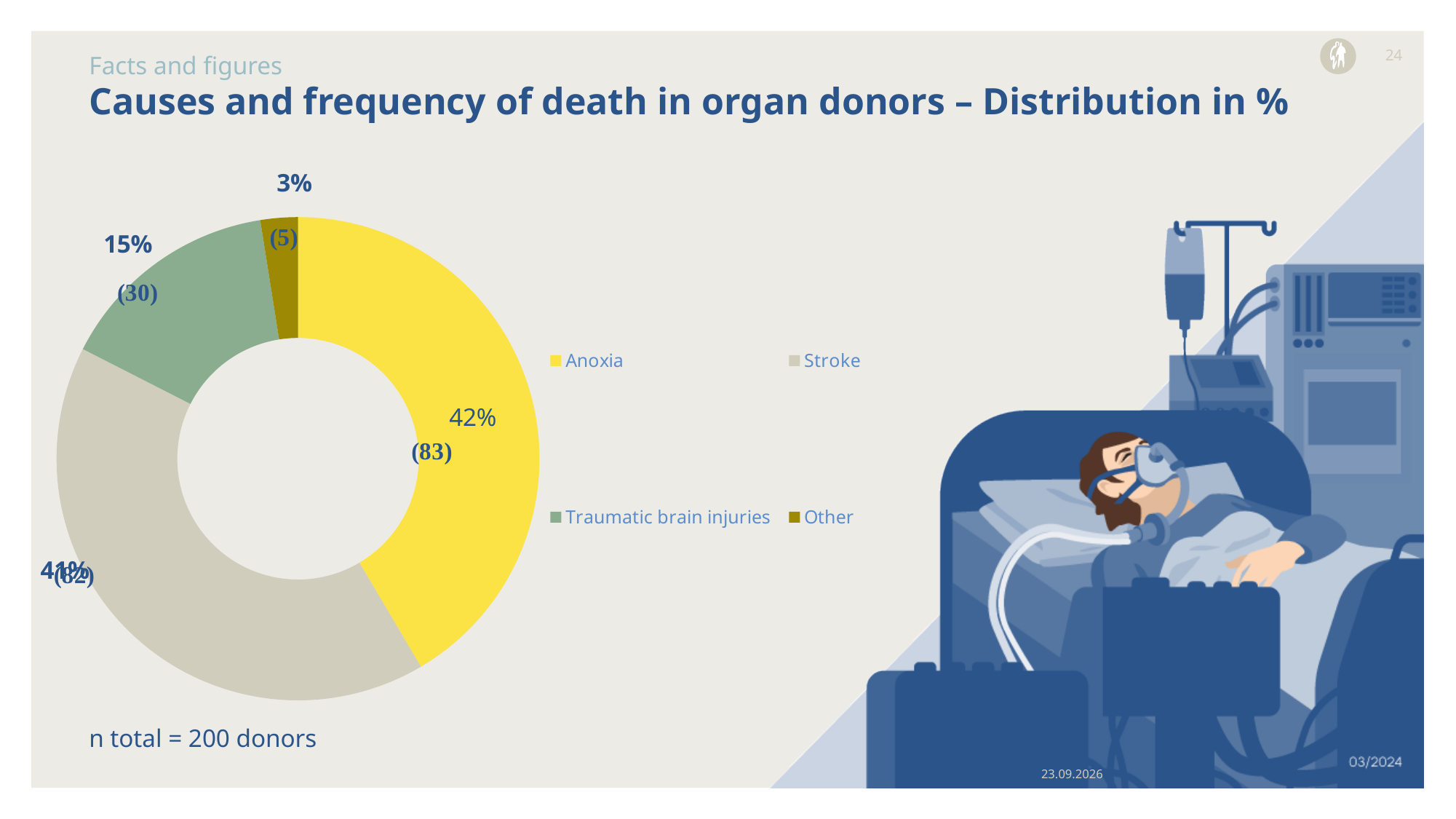
What is the difference in percentage points between Traumatic brain injuries and Other? 12 What is the total number of donors stated below the chart? 200 donors How many donors are in the Other category, according to the number in parentheses? 5 How many categories does the legend list? 4 What percentage of organ donor deaths is attributed to Traumatic brain injuries? 15% Which cause of death has the smallest share of the chart? Other How many donors are in the Anoxia category, according to the number in parentheses? 83 What percentage of organ donor deaths is attributed to Anoxia? 42% What percentage of organ donor deaths falls under Other? 3% Which cause of death has the largest share of the chart? Anoxia What kind of chart is shown on the slide? Doughnut (pie) chart How many donors are in the Traumatic brain injuries category, according to the number in parentheses? 30